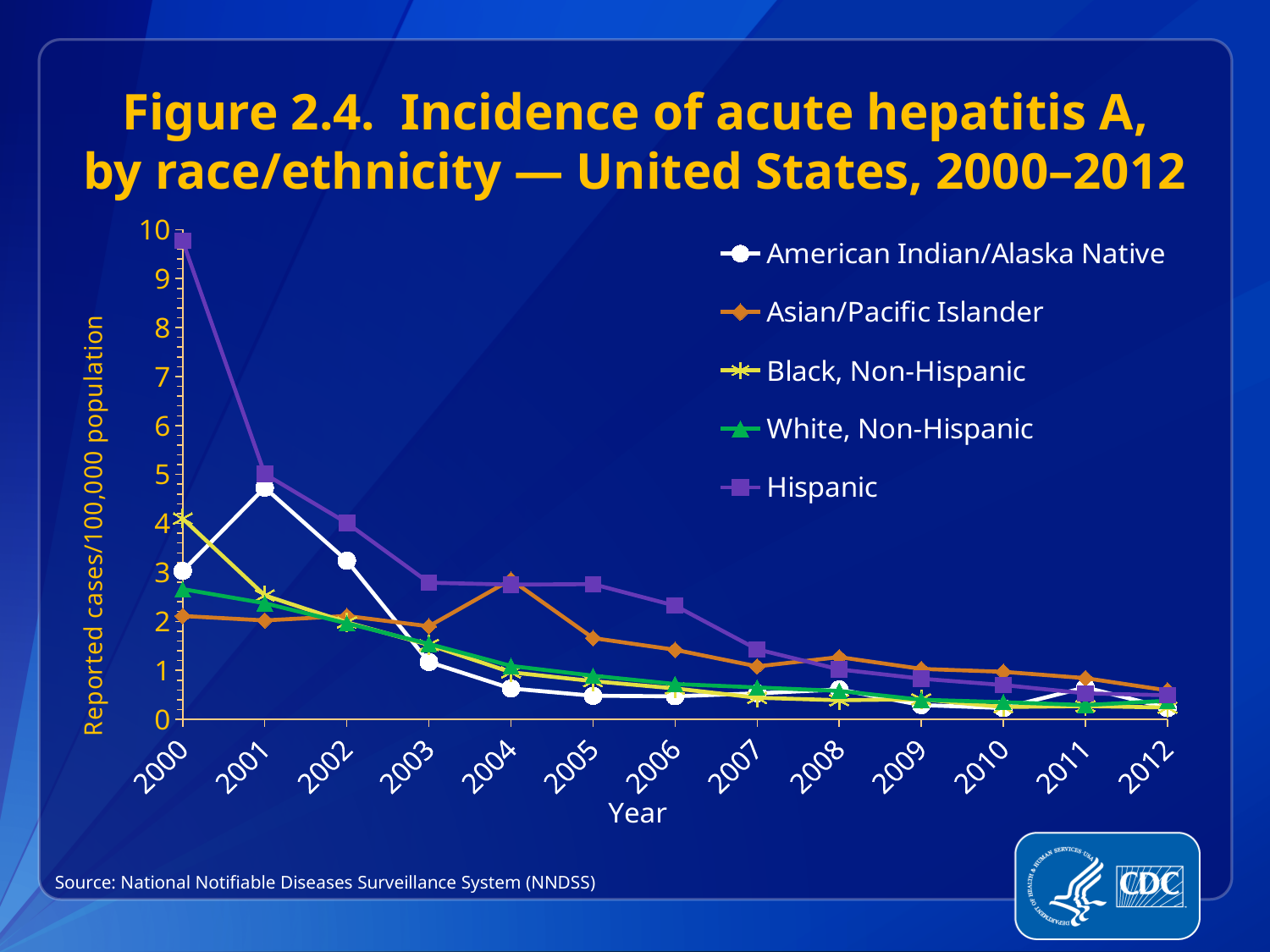
In 2002, which is larger: the value for American Indian/Alaska Native or the value for Asian/Pacific Islander? American Indian/Alaska Native Is the value for Hispanic in 2003 greater or less than 3? less How many series does the legend list? 5 Which group had the lowest incidence in 2004? American Indian/Alaska Native Is the value for American Indian/Alaska Native in 2001 greater or less than 4? greater Is the value for Hispanic in 2000 greater or less than 9? greater What kind of chart is shown on the slide? Line chart Which group had the highest incidence in 2005? Hispanic Which race/ethnicity group had the highest incidence in 2000? Hispanic Does the Hispanic series generally rise or fall from 2000 to 2012? Fall How many years are plotted along the x axis? 13 What is the label on the y axis? Reported cases/100,000 population